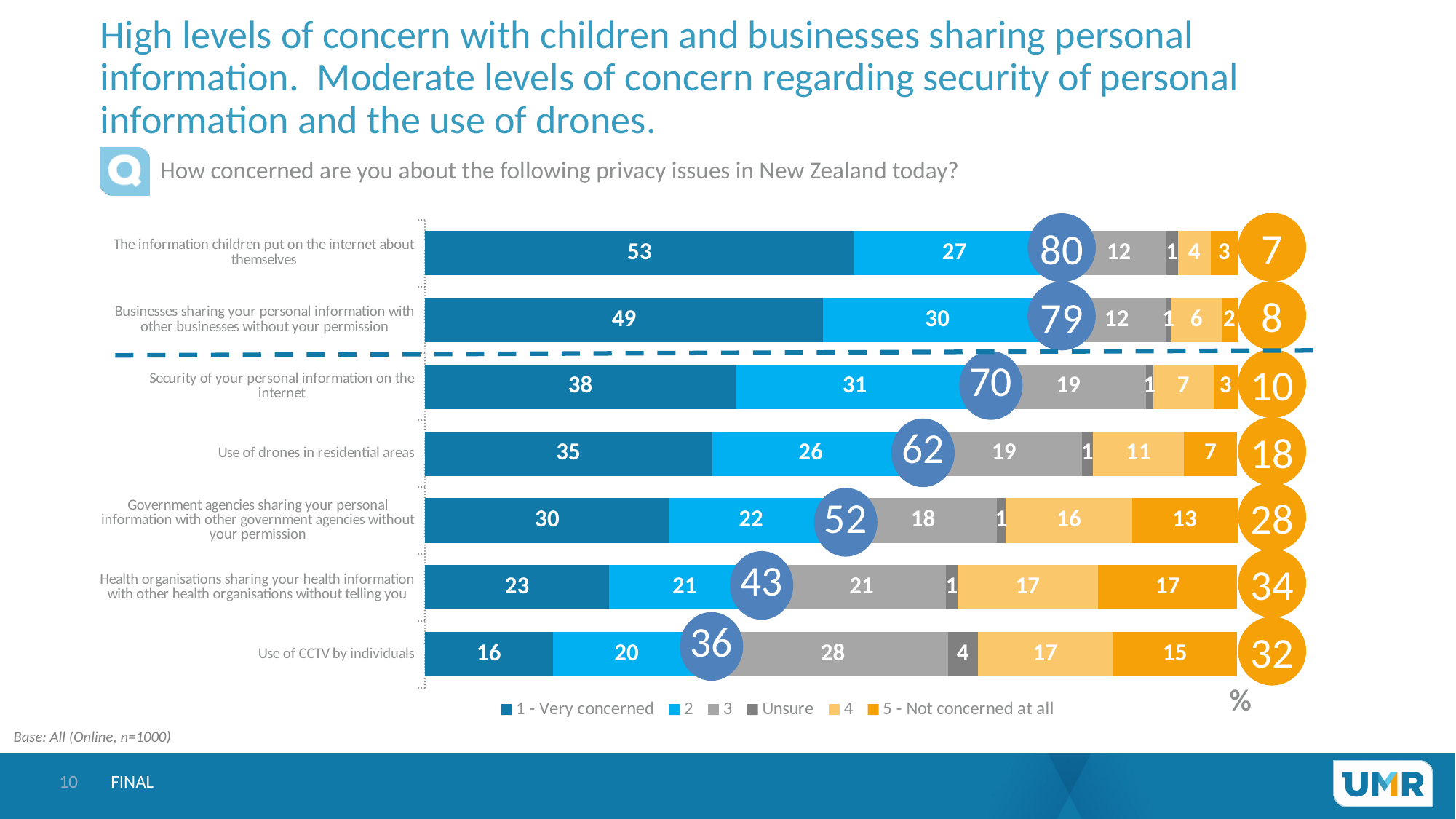
What is the "Unsure" value for "Use of CCTV by individuals"? 4 Which has the larger "4" value: "Government agencies sharing your personal information with other government agencies without your permission" or "Use of drones in residential areas"? Government agencies sharing your personal information with other government agencies without your permission How many privacy issues (categories) are shown in the chart? 7 What kind of chart is shown on the slide? Stacked bar chart What is the value for "1 - Very concerned" for "The information children put on the internet about themselves"? 53 What is the value for "5 - Not concerned at all" for "Use of CCTV by individuals"? 15 Which category has the highest "1 - Very concerned" value? The information children put on the internet about themselves What is the difference between the "3" value for "Use of CCTV by individuals" and the "3" value for "The information children put on the internet about themselves"? 16 Which category has the lowest "1 - Very concerned" value? Use of CCTV by individuals Which legend entry is represented by the darkest blue segments? 1 - Very concerned What combined value is shown in the orange circle for "Health organisations sharing your health information with other health organisations without telling you"? 34 How many series does the legend list? 6